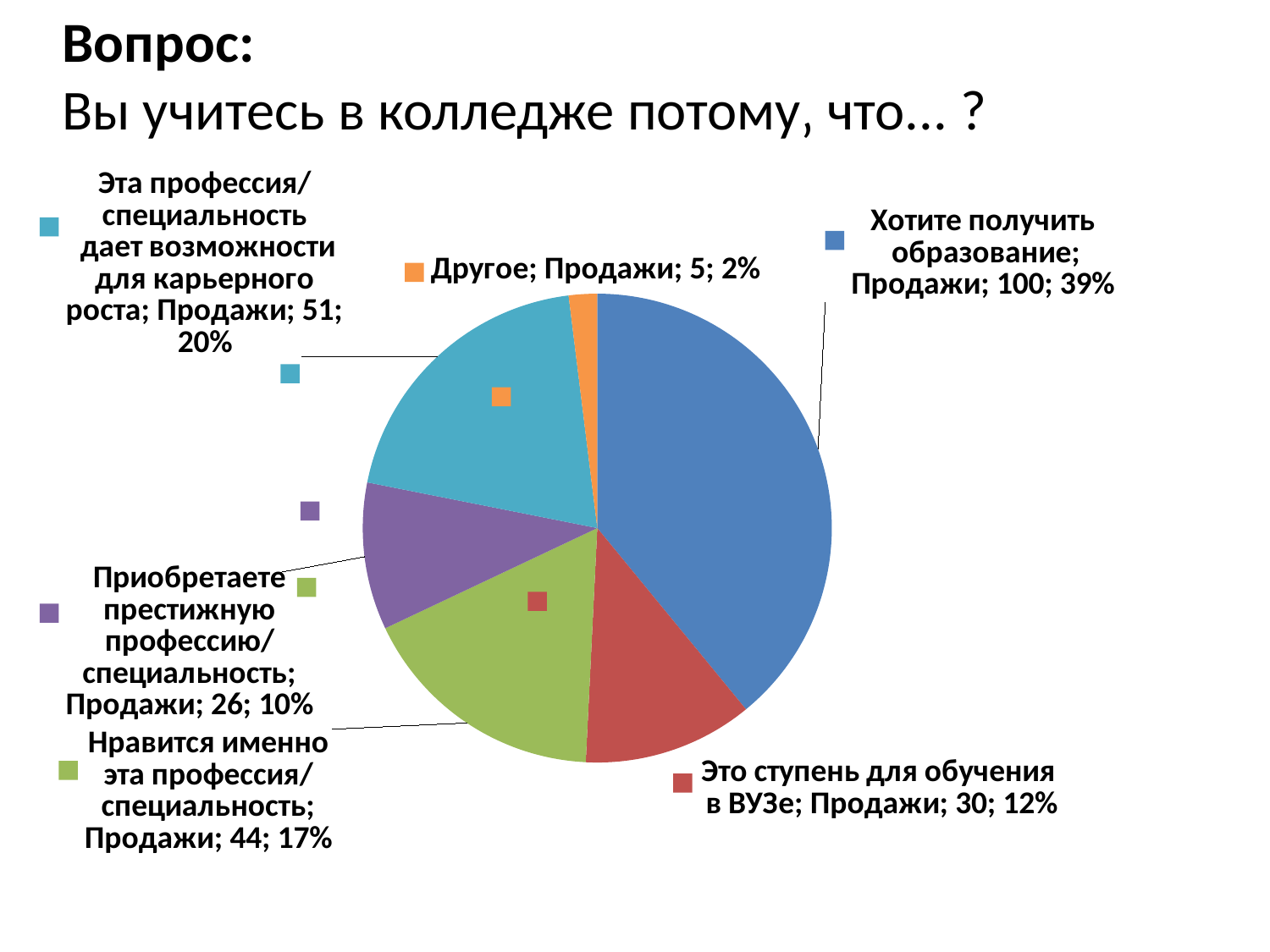
What kind of chart is shown on the slide? pie chart What is the difference between the values for "Хотите получить образование" and "Эта профессия/специальность дает возможности для карьерного роста"? 49 What colour is the slice for "Хотите получить образование"? blue What percentage share does the slice "Это ступень для обучения в ВУЗе" have? 12% Which is larger: the value for "Приобретаете престижную профессию/специальность" or for "Это ступень для обучения в ВУЗе"? Это ступень для обучения в ВУЗе What value is shown for the slice "Хотите получить образование"? 100 Which slice of the pie chart is the largest? Хотите получить образование How many slices does the pie chart have? 6 Which slice of the pie chart is the smallest? Другое What value is shown for the slice "Нравится именно эта профессия/специальность"? 44 What is the value shown for the slice "Другое"? 5 What percentage share does the slice "Эта профессия/специальность дает возможности для карьерного роста" have? 20%